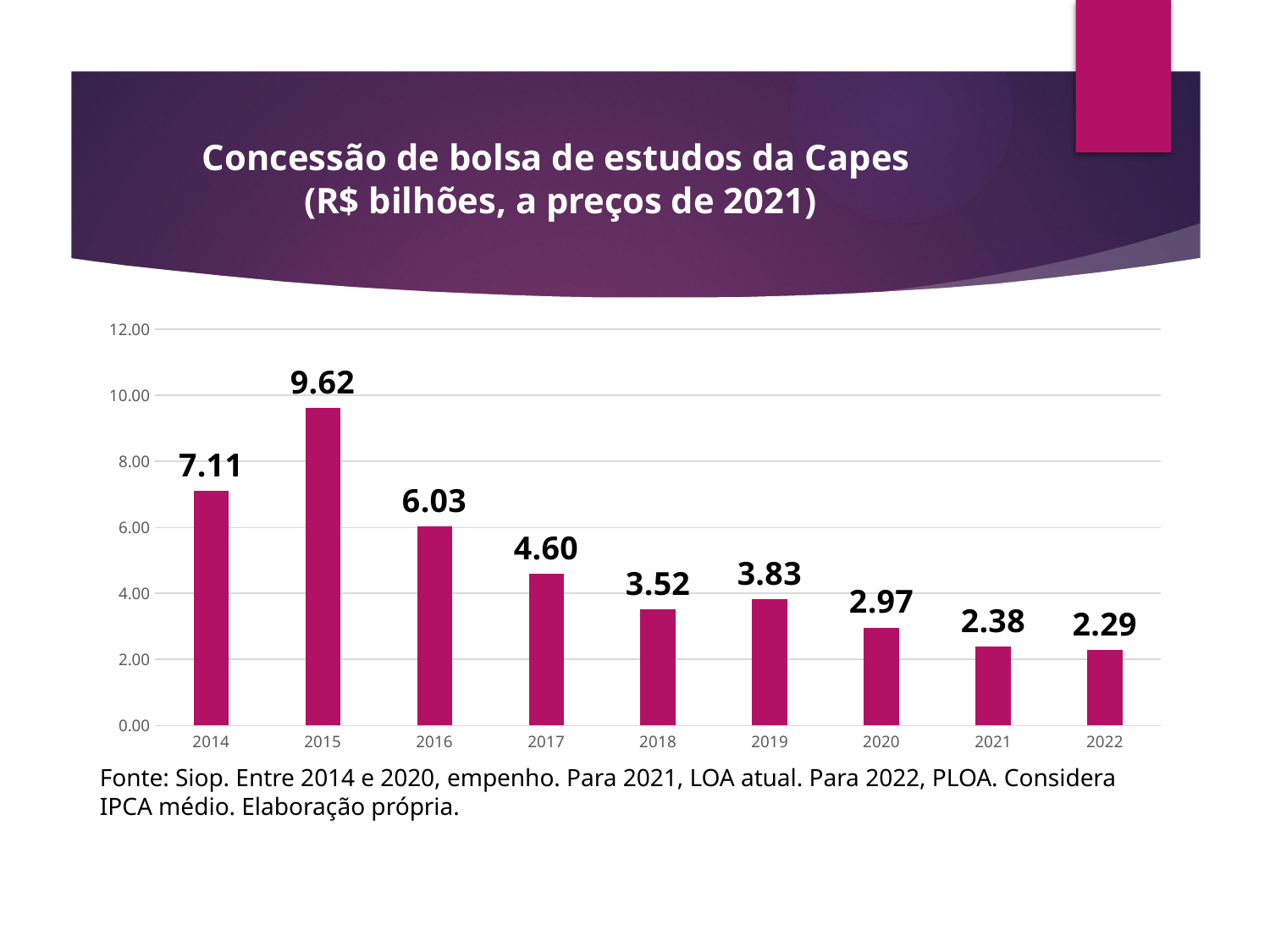
What is the value for 2015? 9.62 Which is larger, the value for 2018 or the value for 2019? 2019 What is the difference between the values for 2014 and 2022? 4.82 Which year has the highest value? 2015 What is the value for 2018? 3.52 Which year has the lowest value? 2022 What is the value for 2022? 2.29 What is the difference between the values for 2015 and 2016? 3.59 What kind of chart is shown on the slide? bar chart Do the values generally rise or fall from 2015 to 2022? fall How many years are shown on the x axis? 9 Is the value for 2017 greater or less than 4.00? greater